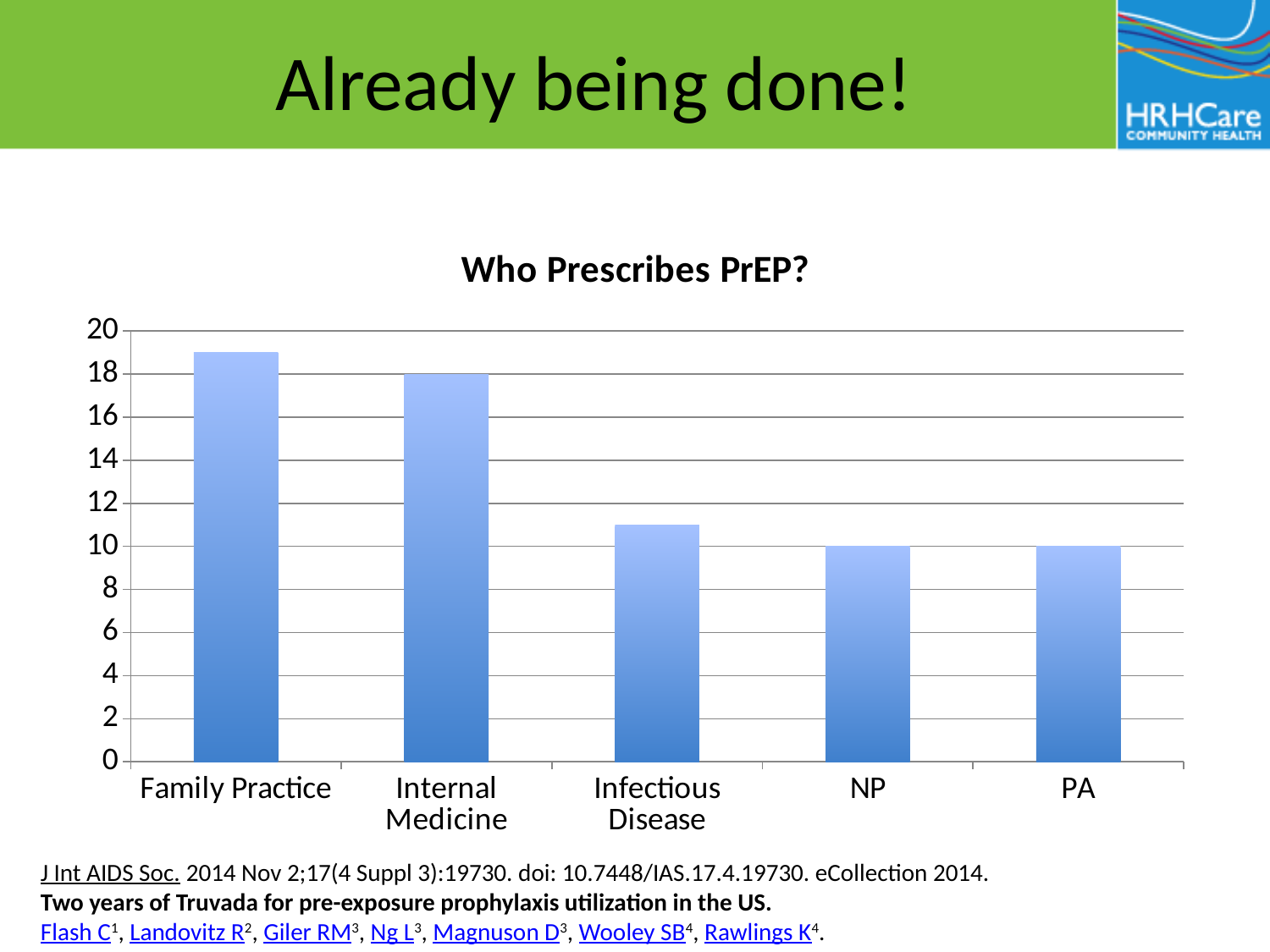
What is the value for PA in the Who Prescribes PrEP? chart? 10 What is the value for Internal Medicine in the Who Prescribes PrEP? chart? 18 Which category has the highest value in the Who Prescribes PrEP? chart? Family Practice What is the difference between the values for Internal Medicine and NP? 8 What is the title of the chart? Who Prescribes PrEP? What is the value for NP in the Who Prescribes PrEP? chart? 10 What kind of chart is shown on the slide? bar chart Which is larger, the value for Family Practice or the value for Infectious Disease? Family Practice Is the value for Family Practice greater or less than 18? greater How many categories are shown on the x axis of the chart? 5 Is the value for Infectious Disease greater or less than 10? greater Is the value for Infectious Disease greater or less than 12? less